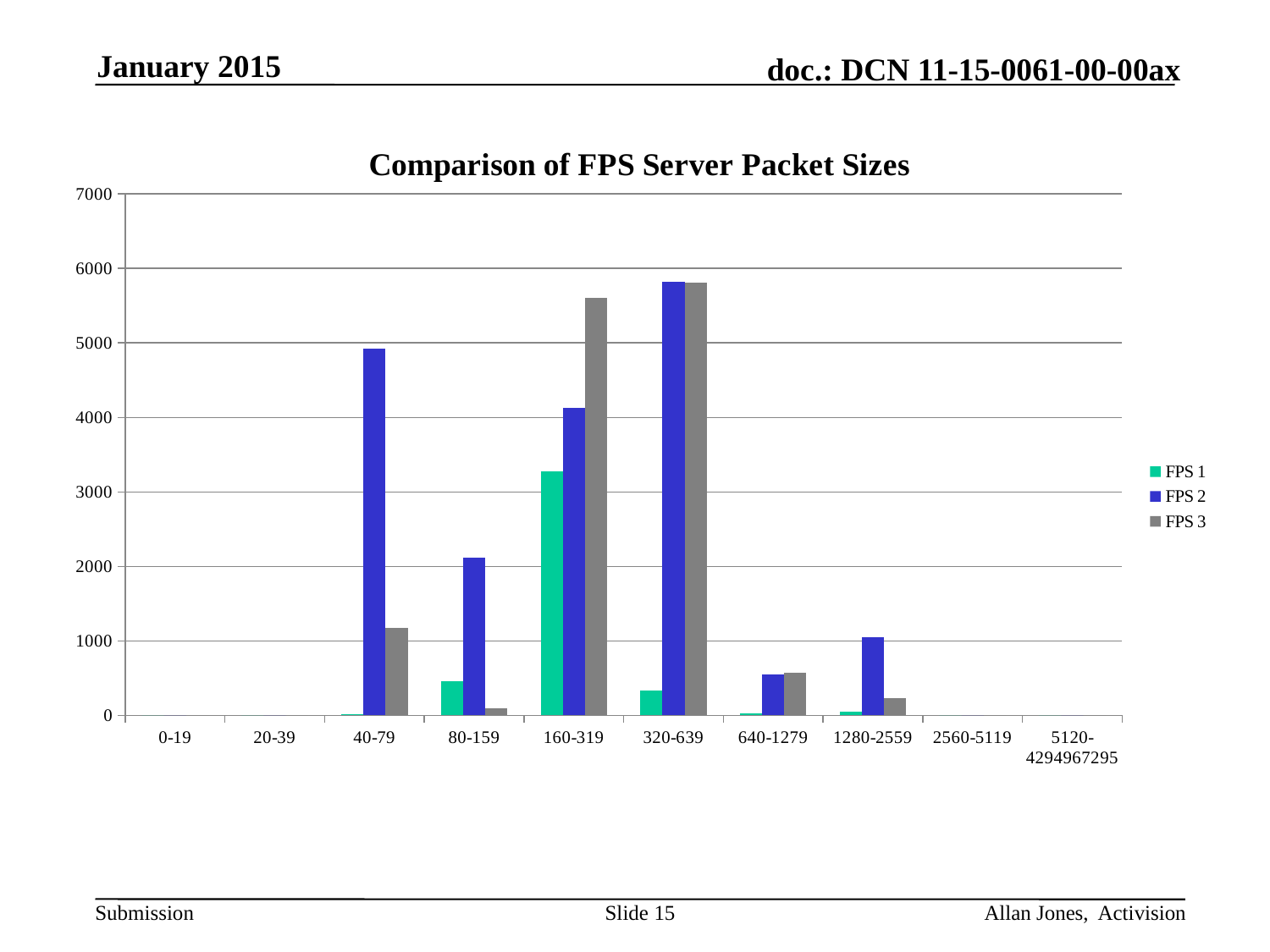
For which packet size category is the FPS 1 value highest? 160-319 In the 160-319 category, which is larger: FPS 1 or FPS 3? FPS 3 What is the title of the chart? Comparison of FPS Server Packet Sizes For which packet size category is the FPS 2 value highest? 320-639 How many series does the legend list? 3 Is the FPS 3 value for 40-79 greater or less than 2000? less Is the FPS 3 value for 160-319 greater or less than 5000? greater How many packet size categories are shown on the x axis? 10 Is the FPS 2 value for 40-79 greater or less than 4000? greater What kind of chart is shown on the slide? bar chart In the 40-79 category, which is larger: FPS 2 or FPS 3? FPS 2